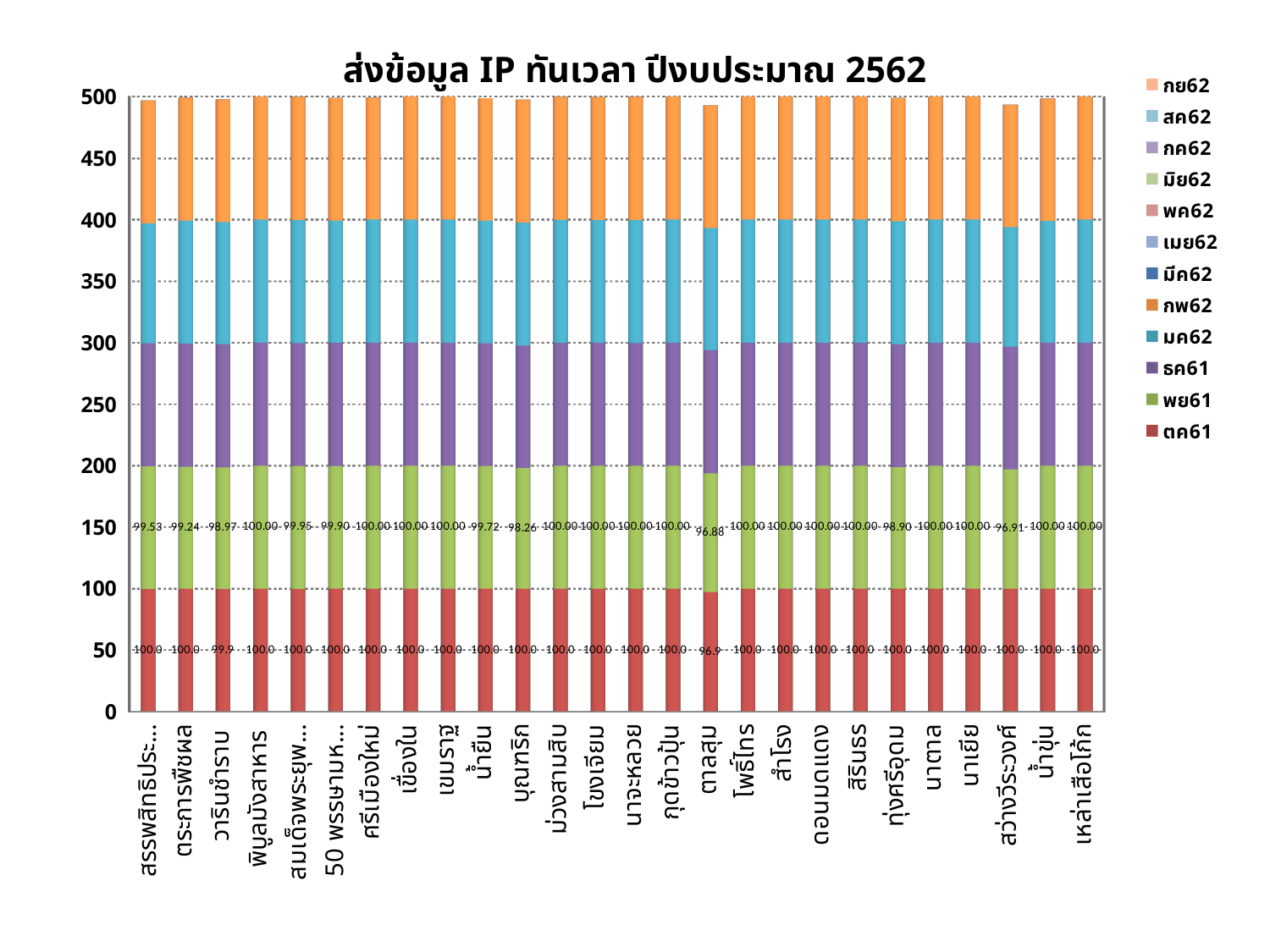
What is the ตค61 value for วารินชำราบ? 99.9 What is the พย61 value for บุณฑริก? 98.26 What type of chart is shown on the slide? stacked bar chart What is the difference between the พย61 values for พิบูลมังสาหาร and ตาลสุม? 3.12 What is the พย61 value for ตาลสุม? 96.88 What is the ตค61 value for ตาลสุม? 96.9 How many categories are shown on the x axis? 26 How many series does the legend list? 12 Is the total stacked value for ตาลสุม greater or less than 450? greater Which has the larger พย61 value, ตระการพืชผล or วารินชำราบ? ตระการพืชผล What is the title of the chart? ส่งข้อมูล IP ทันเวลา ปีงบประมาณ 2562 Which category has the lowest พย61 value? ตาลสุม